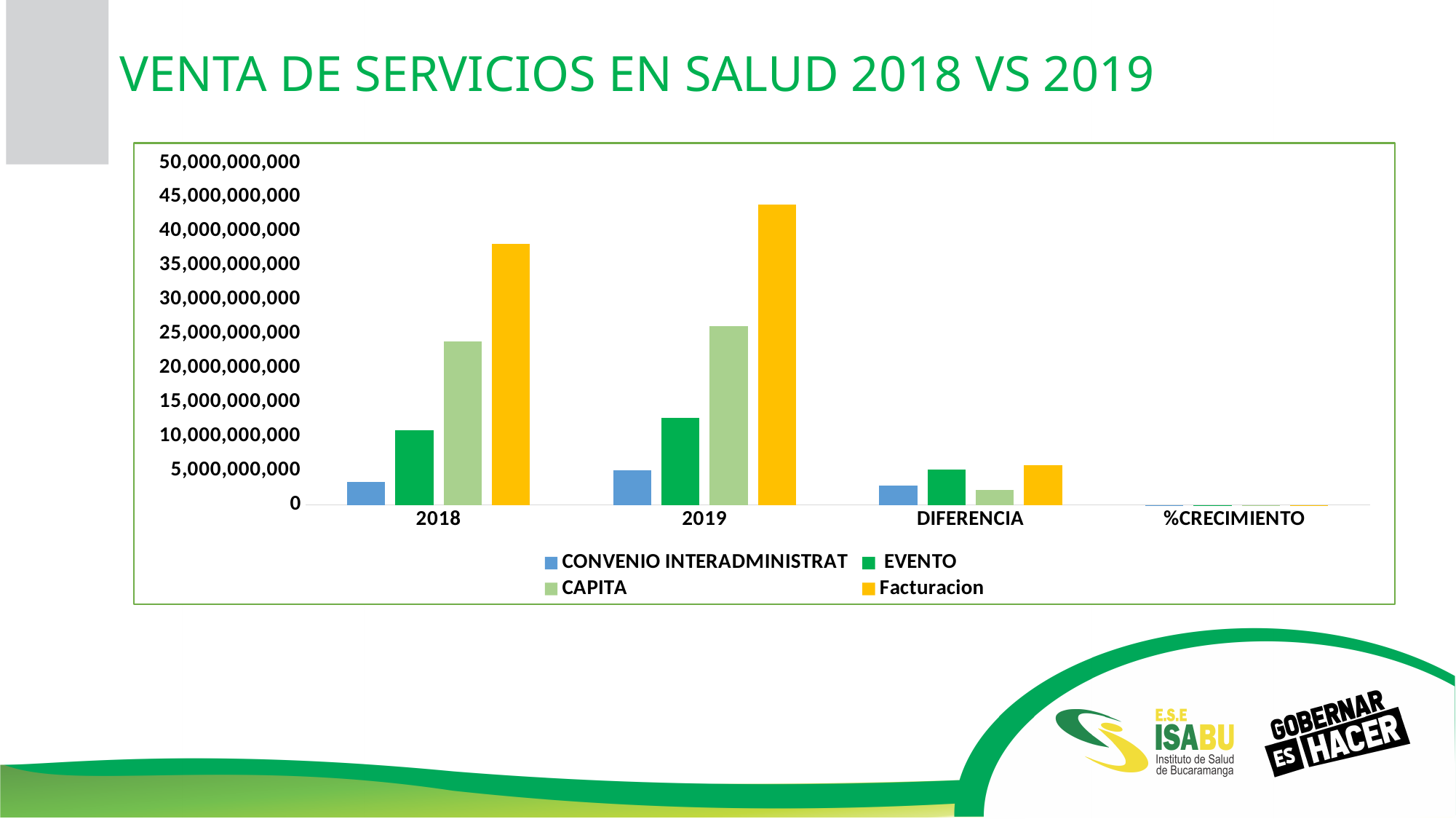
Which is larger, the Facturacion value for 2018 or for 2019? 2019 Is the Facturacion value for 2019 greater or less than 45,000,000,000? less Which series has the highest value in the 2019 category? Facturacion Is the Facturacion value for 2018 greater or less than 35,000,000,000? greater Is the CAPITA value for 2018 greater or less than 20,000,000,000? greater What is the title of the slide containing the chart? VENTA DE SERVICIOS EN SALUD 2018 VS 2019 How many series does the chart's legend list? 4 In the DIFERENCIA category, which is larger, EVENTO or CAPITA? EVENTO What kind of chart is shown on the slide? bar chart Which series has the lowest value in the 2018 category? CONVENIO INTERADMINISTRAT How many categories are shown on the x axis of the chart? 4